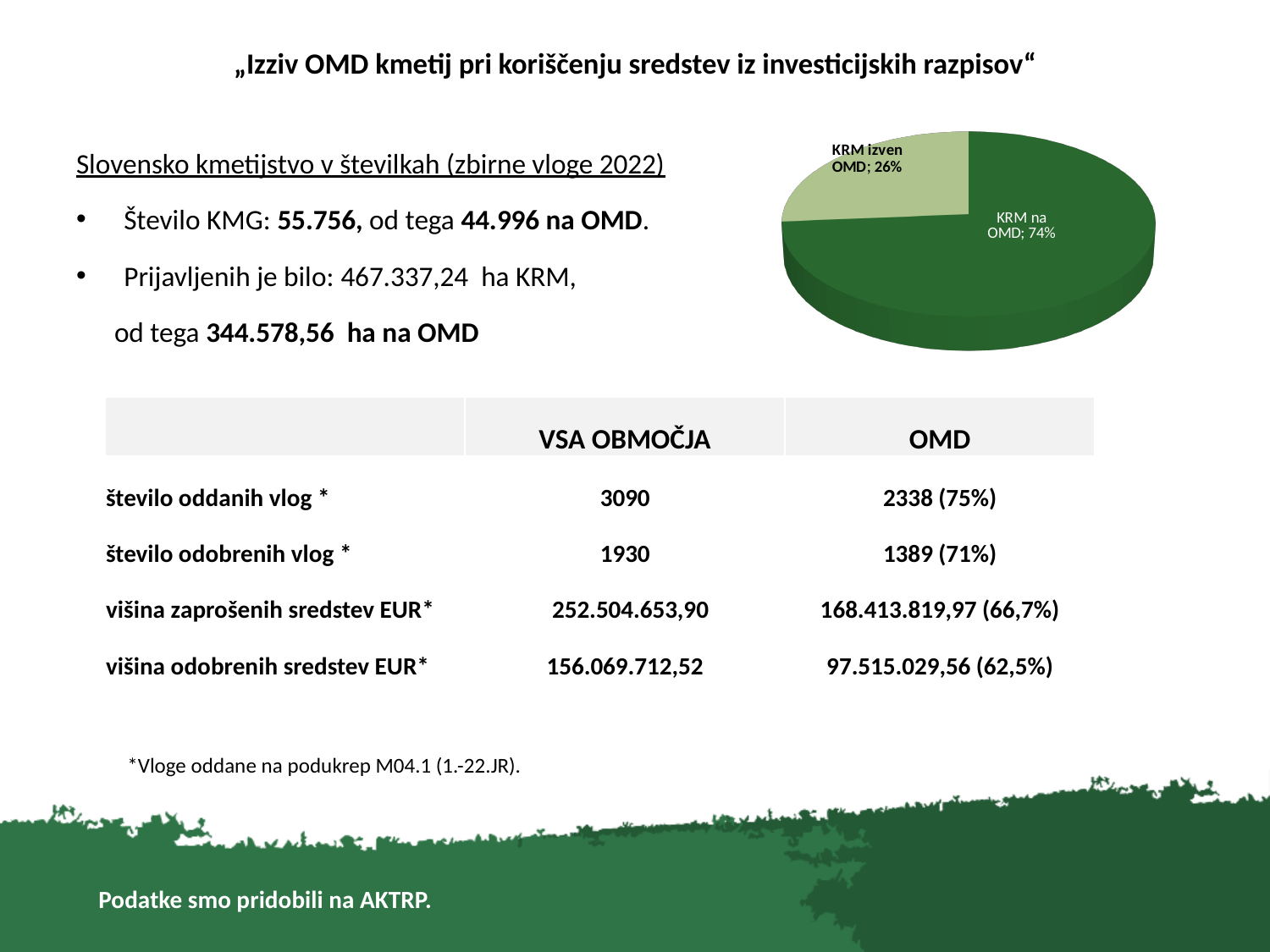
What colour is the KRM izven OMD slice in the pie chart? light green What kind of chart is shown on the slide? pie chart What share of the pie chart is labelled "KRM izven OMD"? 26% How many slices does the pie chart have? 2 What share of the pie chart is labelled "KRM na OMD"? 74% What is the difference in percentage points between the KRM na OMD slice and the KRM izven OMD slice? 48 Which slice of the pie chart is the largest? KRM na OMD In the pie chart, which is larger: KRM na OMD or KRM izven OMD? KRM na OMD What colour is the KRM na OMD slice in the pie chart? dark green Which slice of the pie chart is the smallest? KRM izven OMD Is the share for KRM izven OMD greater or less than 50%? less